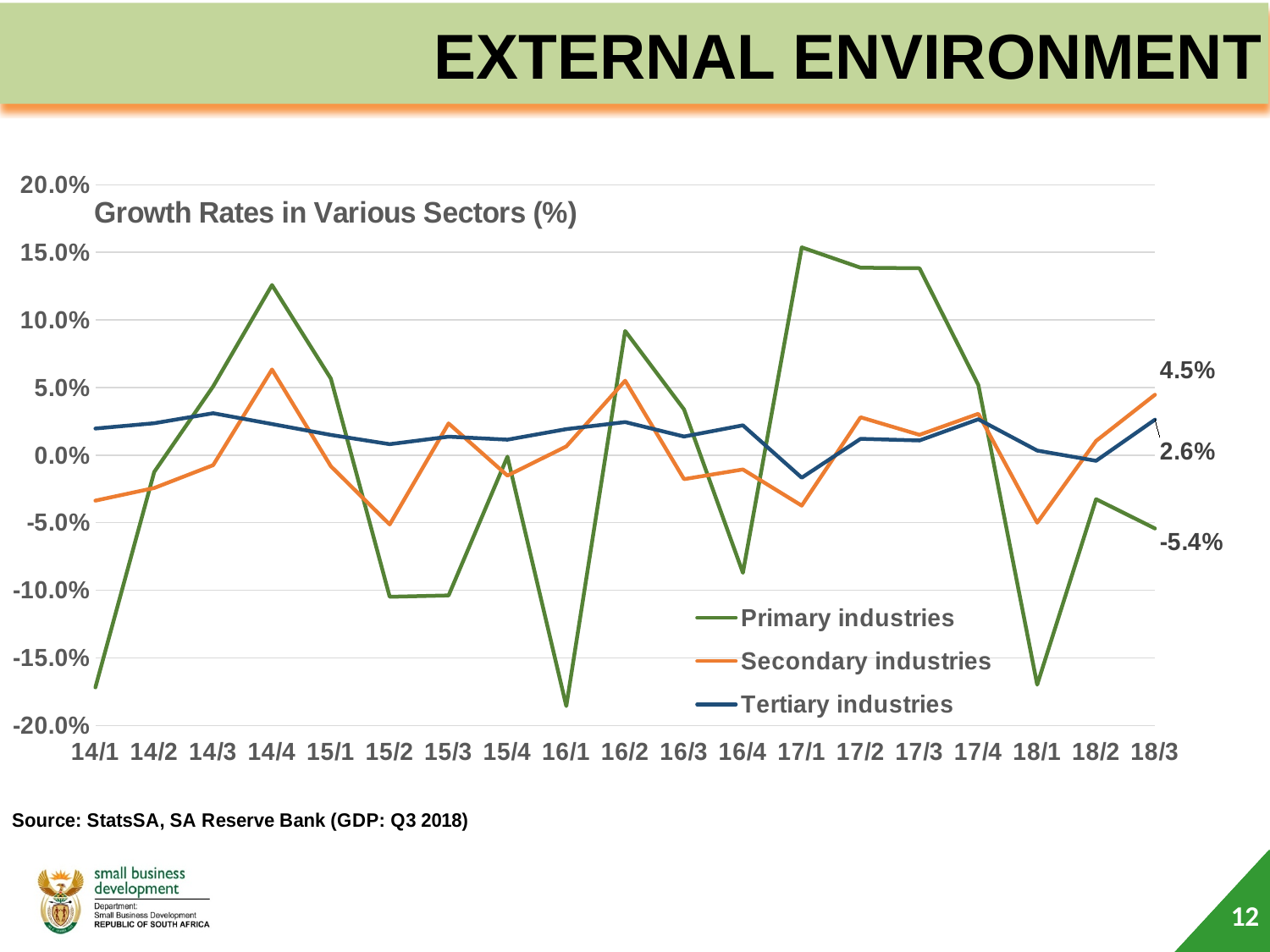
Is the value for Primary industries in 16/1 greater or less than -15.0%? less What kind of chart is shown on the slide? Line chart What is the title of the chart? Growth Rates in Various Sectors (%) How many series does the legend list? 3 In 18/3, which is larger: the growth rate for Secondary industries or for Tertiary industries? Secondary industries Is the value for Primary industries in 17/1 greater or less than 10.0%? greater What is the growth rate for Tertiary industries in 18/3? 2.6% How many quarters are shown along the x axis? 19 What is the growth rate for Primary industries in 18/3? -5.4% What is the difference between the Secondary industries and Primary industries growth rates in 18/3? 9.9 percentage points In 18/3, which series has the highest growth rate? Secondary industries What is the growth rate for Secondary industries in 18/3? 4.5%